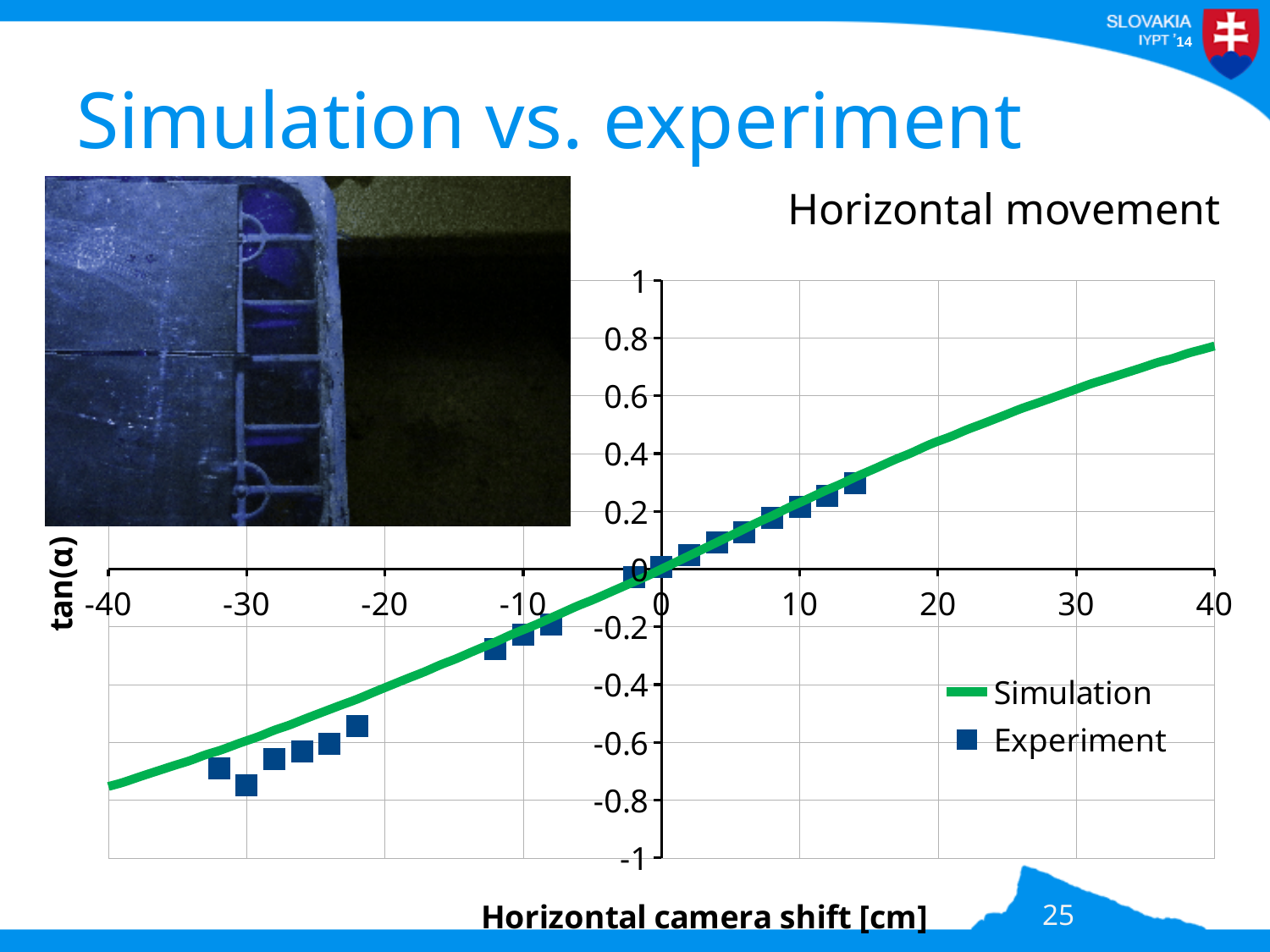
What is the label of the x axis? Horizontal camera shift [cm] Is the Simulation value at a horizontal camera shift of -40 cm greater or less than -0.6? less How many series does the chart legend list? 2 Do the tan(α) values rise or fall as the horizontal camera shift increases from -40 to 40 cm? rise Which is larger, the Simulation value at 40 cm or the Simulation value at 20 cm? at 40 cm Is the Simulation value at a horizontal camera shift of 10 cm greater or less than 0.4? less What kind of chart is shown on the slide? line chart What are the two series named in the legend? Simulation and Experiment Is the Simulation value at a horizontal camera shift of 40 cm greater or less than 0.6? greater What is the title of the chart? Horizontal movement